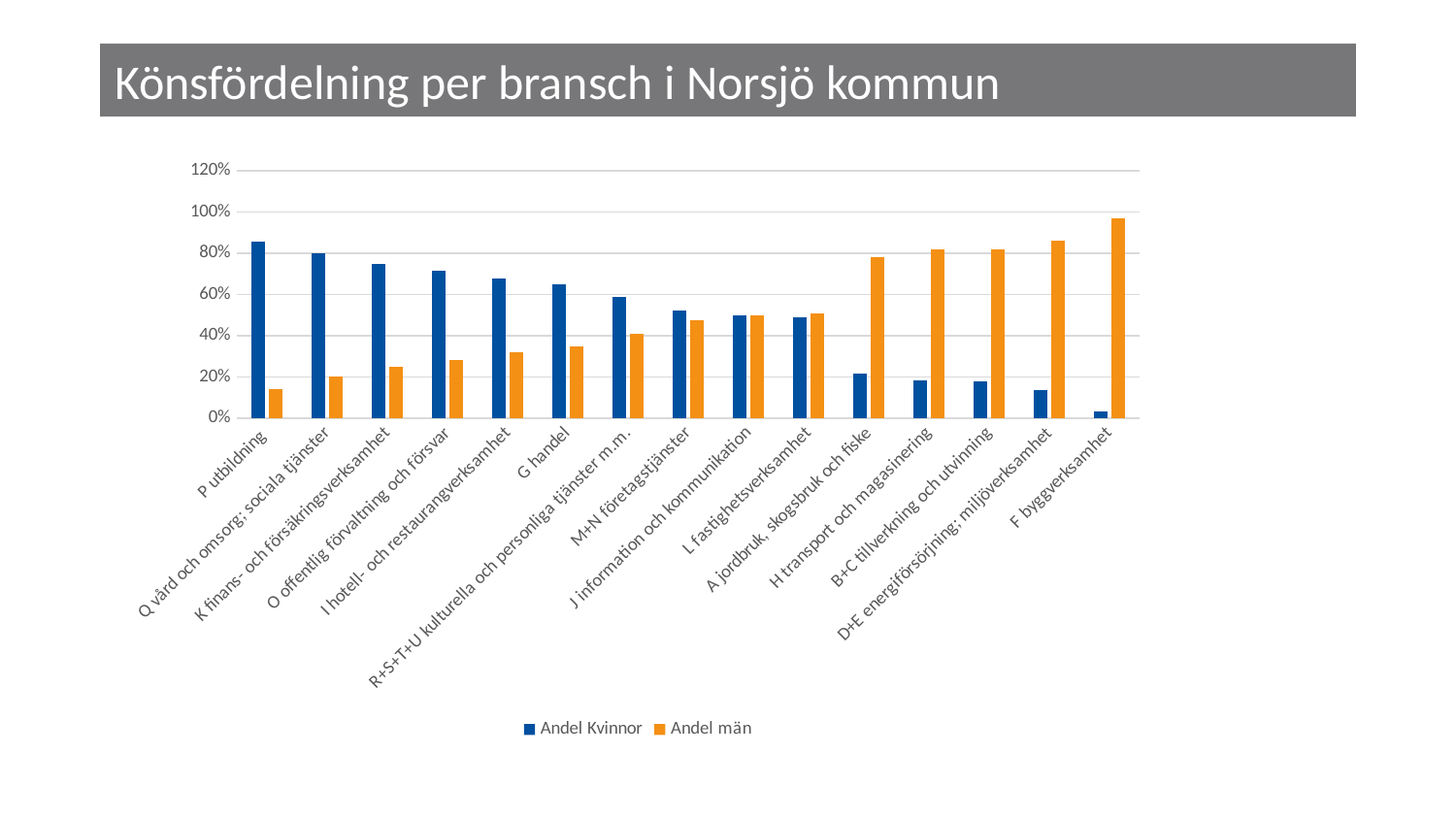
Which category has the lowest value for Andel Kvinnor? F byggverksamhet Is the value for Andel Kvinnor in P utbildning greater or less than 60%? greater Which category has the lowest value for Andel män? P utbildning For F byggverksamhet, which is larger: Andel Kvinnor or Andel män? Andel män How many industry categories are shown on the x axis? 15 Do the values for Andel Kvinnor generally rise or fall from left to right along the x axis? fall How many series does the legend list? 2 Is the value for Andel Kvinnor in H transport och magasinering greater or less than 40%? less Which category has the highest value for Andel män? F byggverksamhet What kind of chart is shown on the slide? bar chart Is the value for Andel män in A jordbruk, skogsbruk och fiske greater or less than 60%? greater Which category has the highest value for Andel Kvinnor? P utbildning